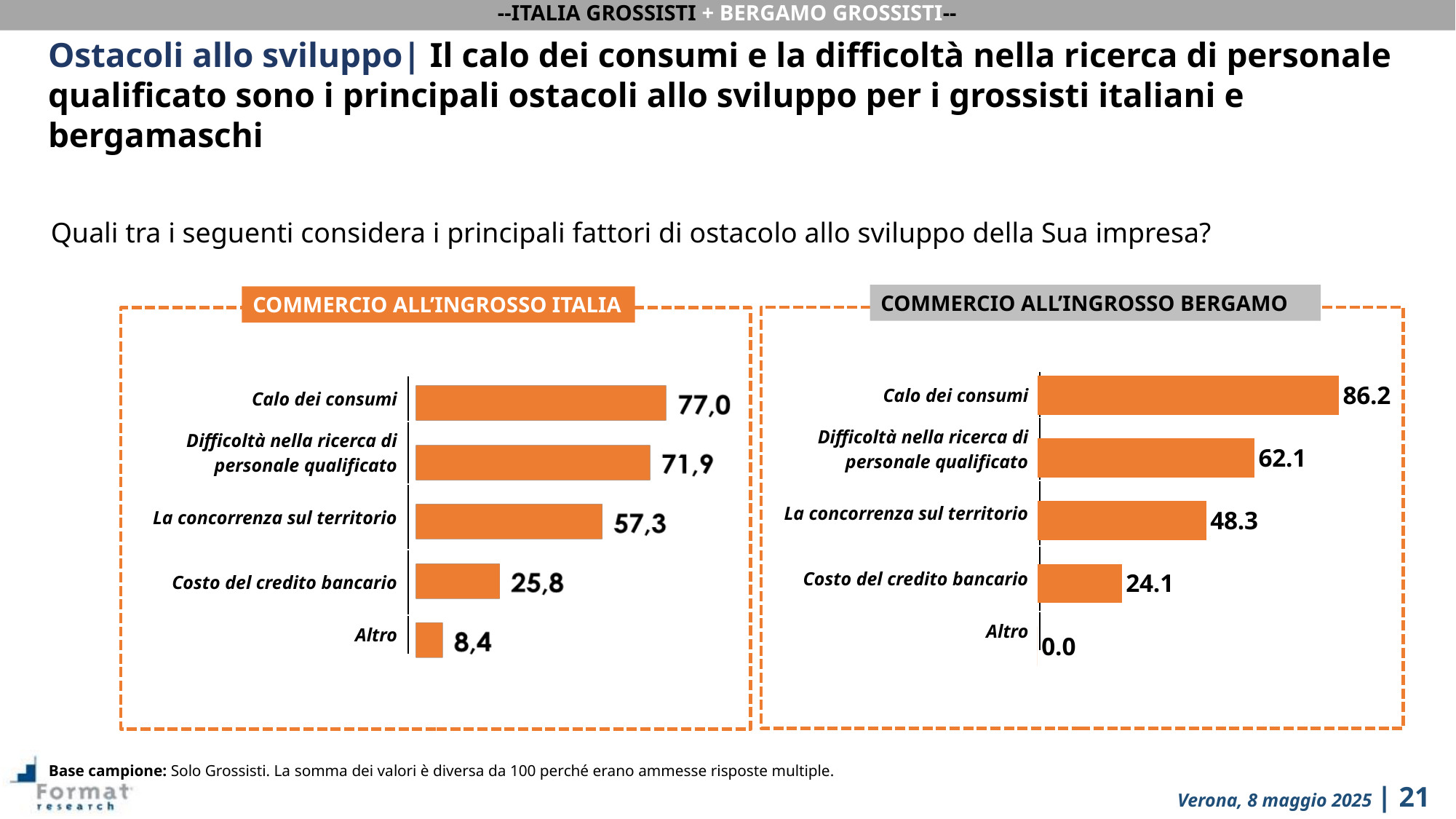
In the COMMERCIO ALL'INGROSSO ITALIA chart, what is the value for Costo del credito bancario? 25,8 In the COMMERCIO ALL'INGROSSO BERGAMO chart, what is the difference between Calo dei consumi and Difficoltà nella ricerca di personale qualificato? 24.1 Which chart shows a larger value for La concorrenza sul territorio, COMMERCIO ALL'INGROSSO ITALIA or COMMERCIO ALL'INGROSSO BERGAMO? COMMERCIO ALL'INGROSSO ITALIA What type of chart is the COMMERCIO ALL'INGROSSO ITALIA chart? Bar chart In the COMMERCIO ALL'INGROSSO ITALIA chart, which category has the lowest value? Altro In the COMMERCIO ALL'INGROSSO BERGAMO chart, which category has the highest value? Calo dei consumi In the COMMERCIO ALL'INGROSSO ITALIA chart, what is the value for Calo dei consumi? 77,0 In the COMMERCIO ALL'INGROSSO ITALIA chart, what is the difference between Calo dei consumi and Difficoltà nella ricerca di personale qualificato? 5,1 What colour are the bars in the COMMERCIO ALL'INGROSSO BERGAMO chart? Orange In the COMMERCIO ALL'INGROSSO BERGAMO chart, what is the value for Difficoltà nella ricerca di personale qualificato? 62.1 How many categories are shown in the COMMERCIO ALL'INGROSSO BERGAMO chart? 5 In the COMMERCIO ALL'INGROSSO BERGAMO chart, what is the value for Altro? 0.0